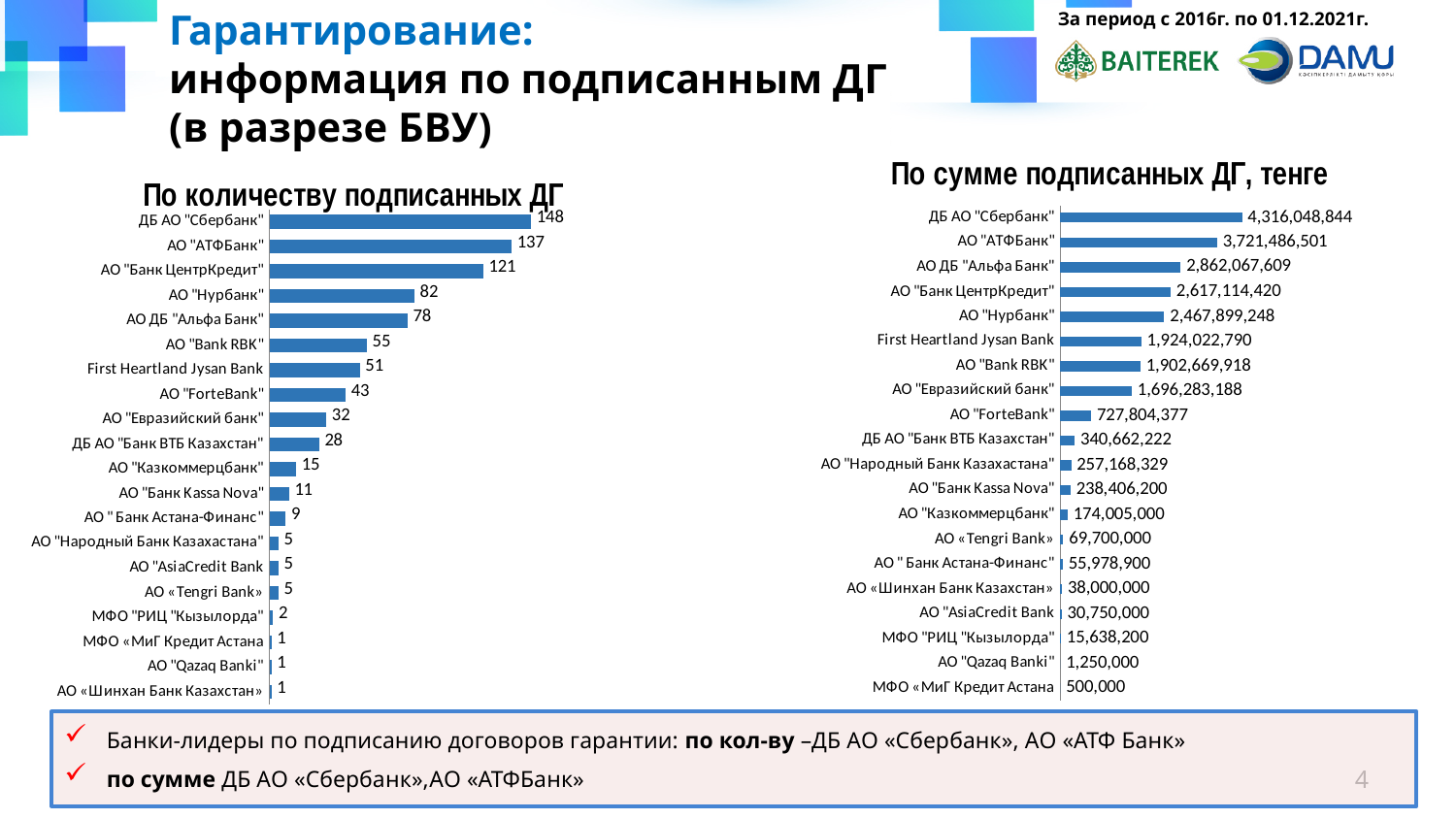
In the chart "По количеству подписанных ДГ", which bank has the highest value? ДБ АО "Сбербанк" In the chart "По сумме подписанных ДГ, тенге", which is larger: АО "Нурбанк" or АО "Банк ЦентрКредит"? АО "Банк ЦентрКредит" In the chart "По сумме подписанных ДГ, тенге", what is the value for АО ДБ "Альфа Банк"? 2,862,067,609 In the chart "По сумме подписанных ДГ, тенге", what is the value for АО "ForteBank"? 727,804,377 In the chart "По количеству подписанных ДГ", what is the difference between ДБ АО "Сбербанк" and АО "АТФБанк"? 11 In the chart "По количеству подписанных ДГ", how many banks are listed? 20 In the chart "По сумме подписанных ДГ, тенге", which bank has the lowest value? МФО «МиГ Кредит Астана In the chart "По сумме подписанных ДГ, тенге", what is the difference between ДБ АО "Сбербанк" and АО "АТФБанк"? 594,562,343 In the chart "По количеству подписанных ДГ", what is the value for АО "Нурбанк"? 82 In the chart "По количеству подписанных ДГ", what is the value for АО "Банк Kassa Nova"? 11 In the chart "По количеству подписанных ДГ", which is larger: АО "Bank RBK" or First Heartland Jysan Bank? АО "Bank RBK" What type of chart is "По сумме подписанных ДГ, тенге"? bar chart